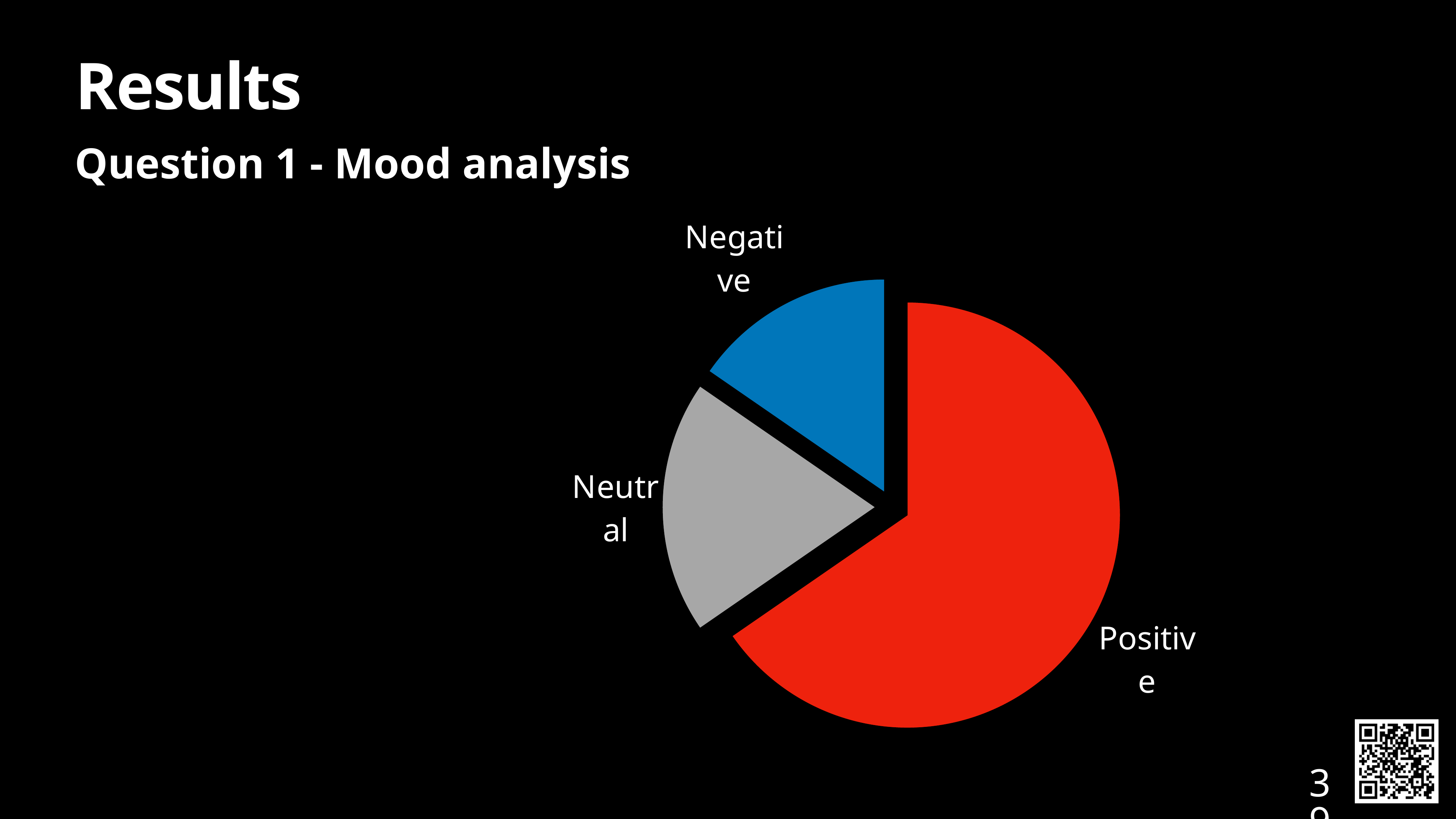
What colour is the Positive slice of the pie chart? red Which category has the largest slice of the pie chart? Positive Which slice is larger, Positive or Negative? Positive What kind of chart is shown on the slide? pie chart Does the Positive slice take up more or less than half of the pie chart? more Which slice is larger, Positive or Neutral? Positive How many slices does the pie chart have? 3 Which category is shown in blue on the pie chart? Negative